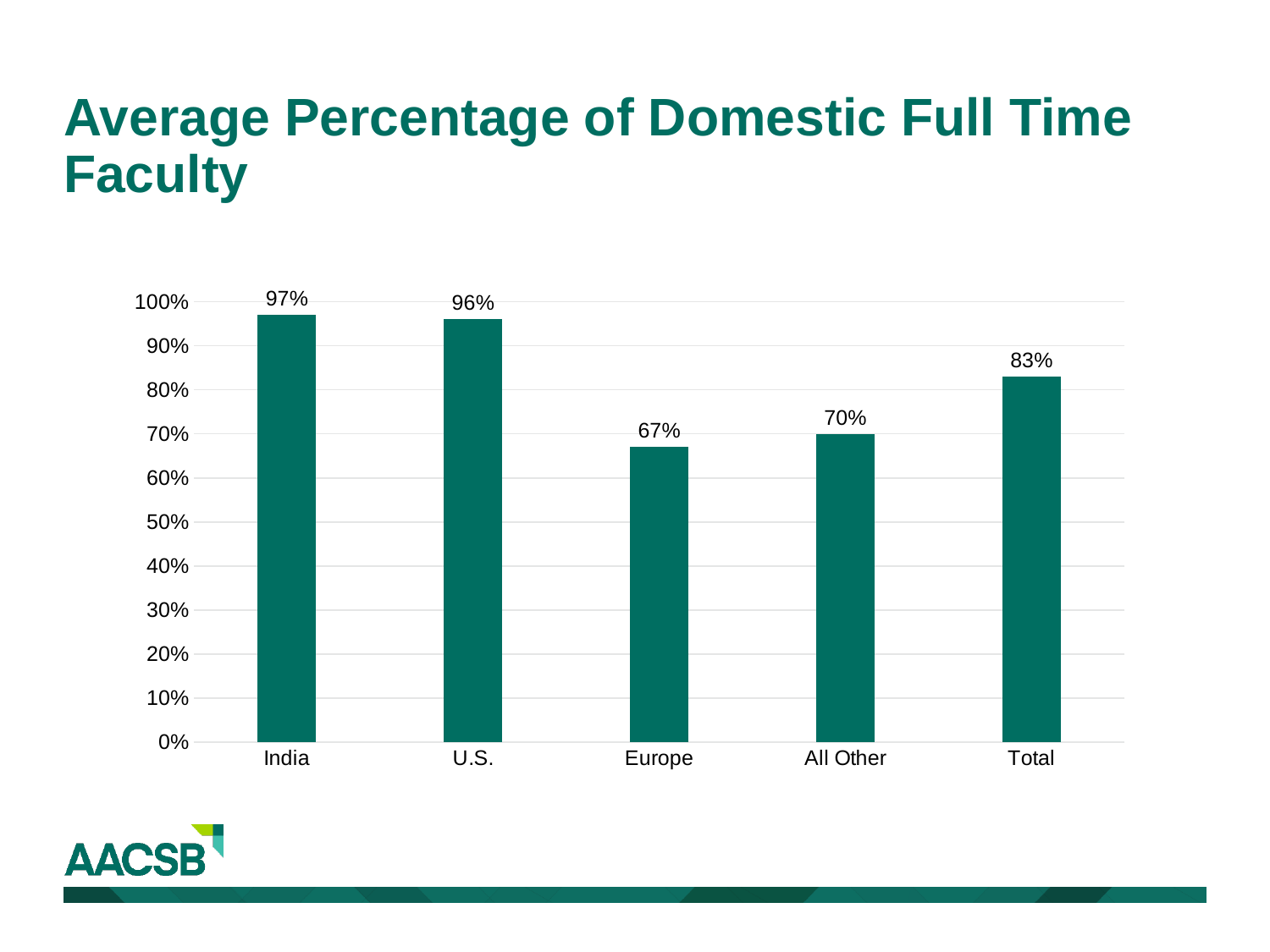
Is the value for All Other greater or less than 80%? less What is the value shown for Europe? 67% What is the title of the chart on the slide? Average Percentage of Domestic Full Time Faculty What is the average percentage of domestic full time faculty for India? 97% Which category has the highest average percentage of domestic full time faculty? India How many categories are shown on the x axis? 5 Which is larger, the value for U.S. or the value for All Other? U.S. Which category has the lowest average percentage of domestic full time faculty? Europe What is the value shown for the Total bar? 83% What is the difference between the values for Total and All Other? 13% What kind of chart is shown on the slide? bar chart What is the difference between the values for India and Europe? 30%